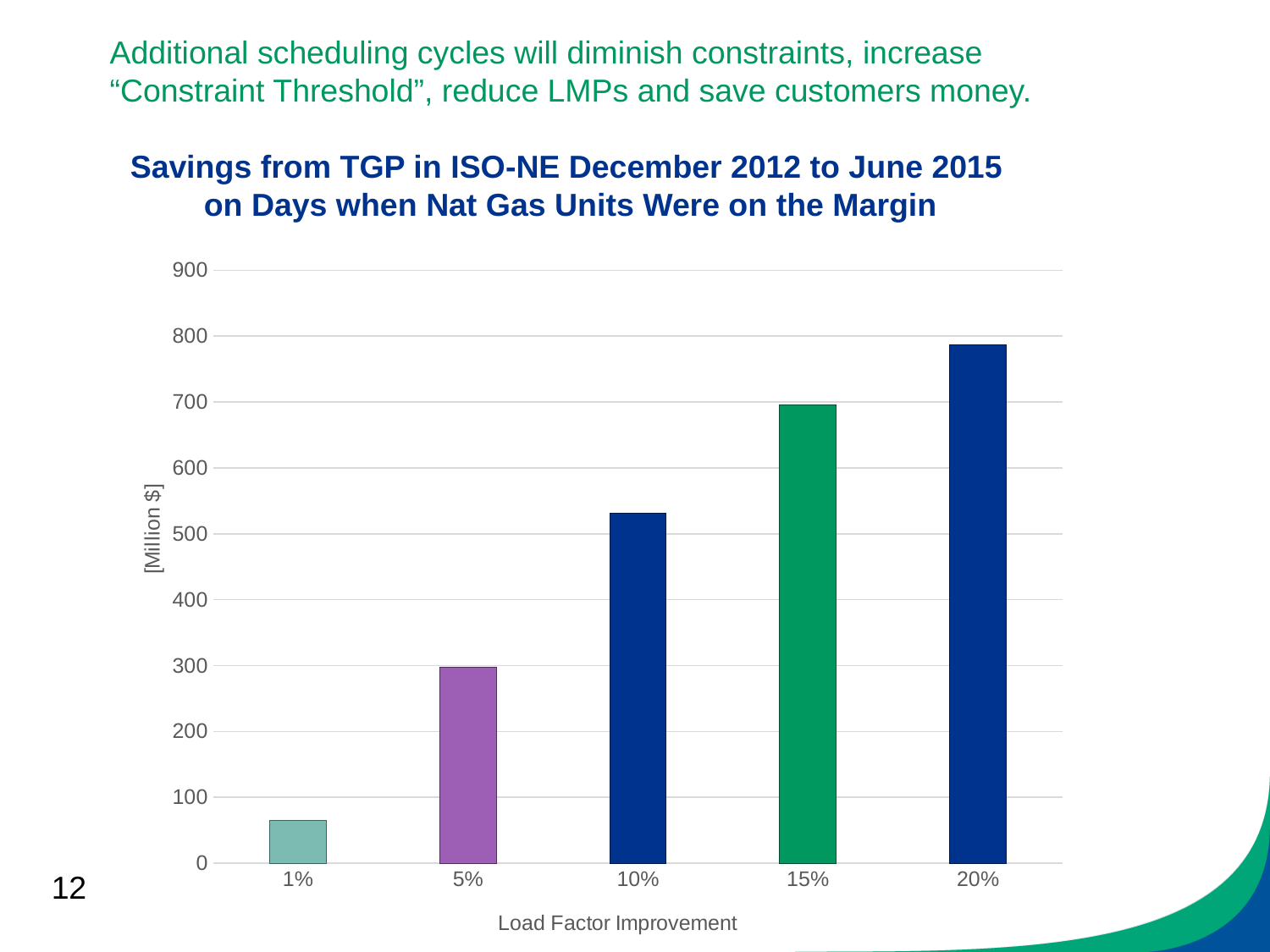
What unit is shown on the y axis? [Million $] Do the savings rise or fall as the load factor improvement increases along the x axis? rise How many bars (load factor improvement categories) are plotted in the chart? 5 What is the label of the x axis? Load Factor Improvement Which has higher savings, the 10% load factor improvement or the 15% load factor improvement? 15% Is the value for the 10% load factor improvement greater or less than 500? greater What kind of chart is shown on the slide? bar chart Which load factor improvement category has the highest savings? 20% Which load factor improvement category has the lowest savings? 1% Is the value for the 5% load factor improvement greater or less than 400? less Is the value for the 20% load factor improvement greater or less than 700? greater